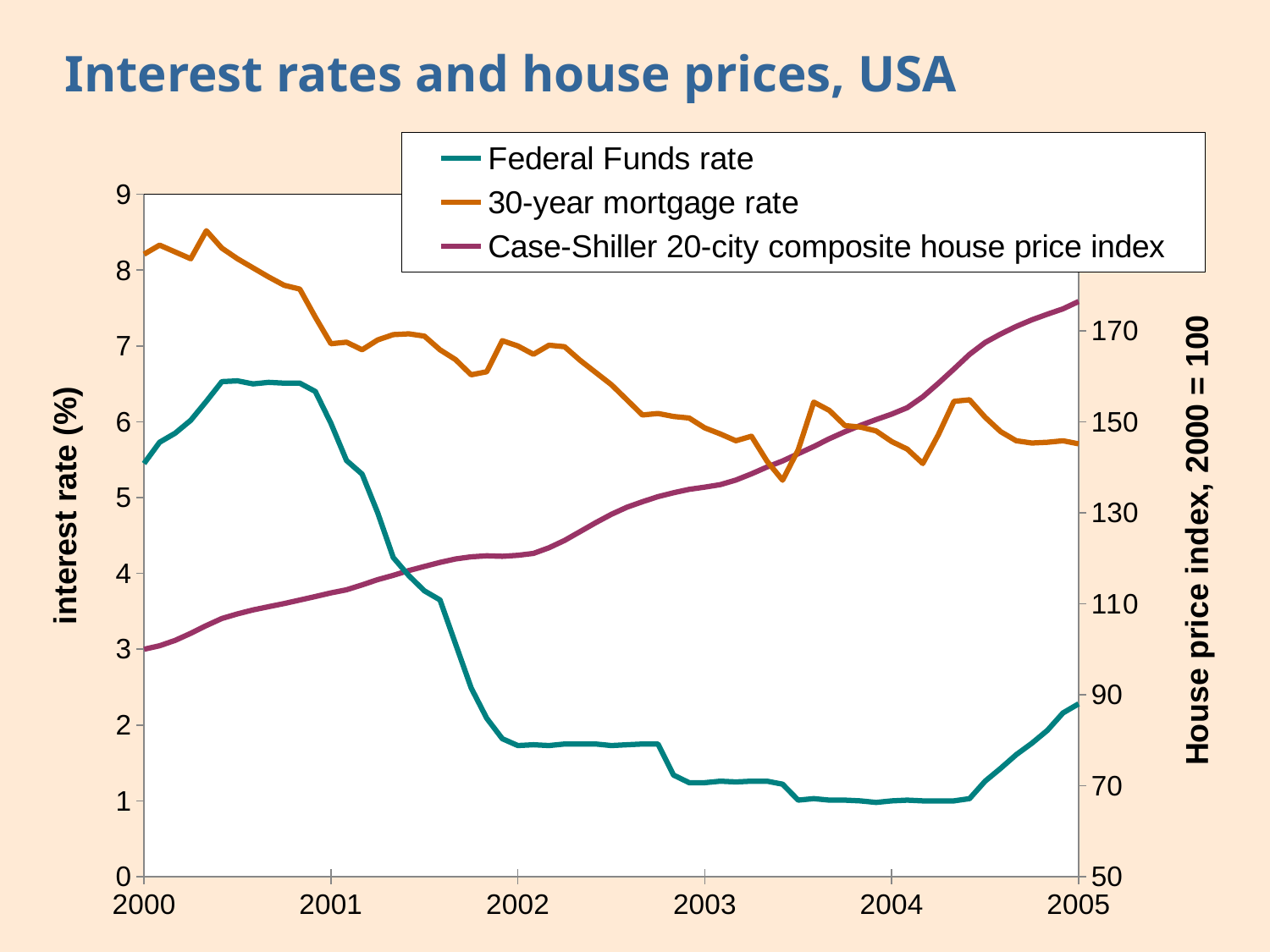
Is the Federal Funds rate at the start of 2000 greater or less than 5? greater What kind of chart is shown on the slide? line chart Is the Case-Shiller 20-city composite house price index at 2005 greater or less than 170? greater What is the title of the chart? Interest rates and house prices, USA What is the label of the right-hand vertical axis? House price index, 2000 = 100 Does the Case-Shiller 20-city composite house price index rise or fall between 2000 and 2005? rise How many year labels are shown on the x axis? 6 At 2005, which is higher: the 30-year mortgage rate or the Federal Funds rate? 30-year mortgage rate Does the Federal Funds rate rise or fall between 2000 and 2004? fall Is the 30-year mortgage rate at the start of 2000 greater or less than 8? greater How many series does the legend list? 3